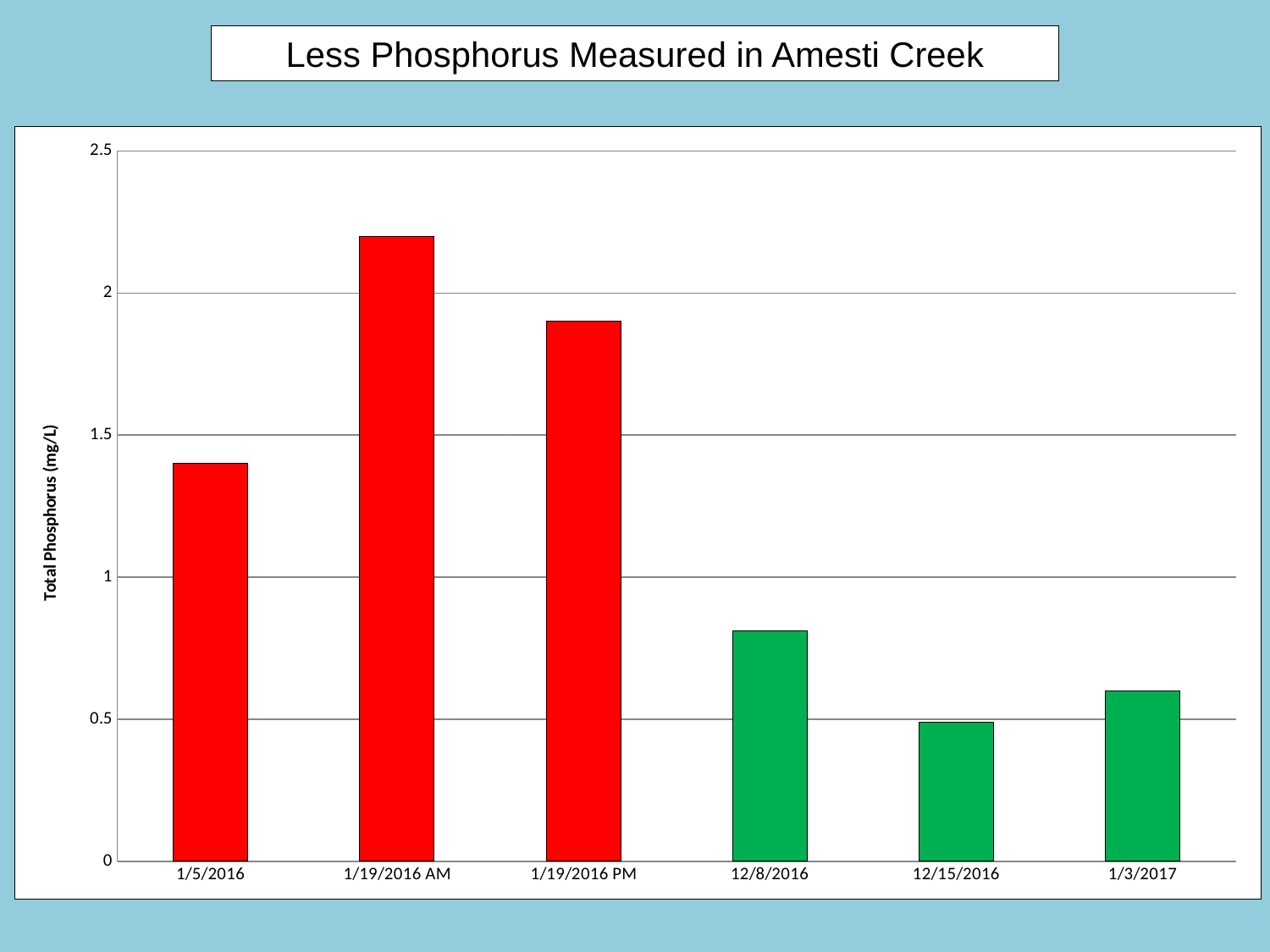
Is the value for 1/19/2016 PM greater or less than 2? less What kind of chart is shown on the slide? bar chart Is the value for 12/8/2016 greater or less than 1? less Is the value for 1/5/2016 greater or less than 1? greater Do the values rise or fall from 1/19/2016 AM to 12/15/2016? fall Which date has the lowest total phosphorus value? 12/15/2016 Which is larger, the value for 1/5/2016 or the value for 12/8/2016? 1/5/2016 Which date has the highest total phosphorus value? 1/19/2016 AM What is the label on the y axis? Total Phosphorus (mg/L) How many dates (categories) are shown on the x axis? 6